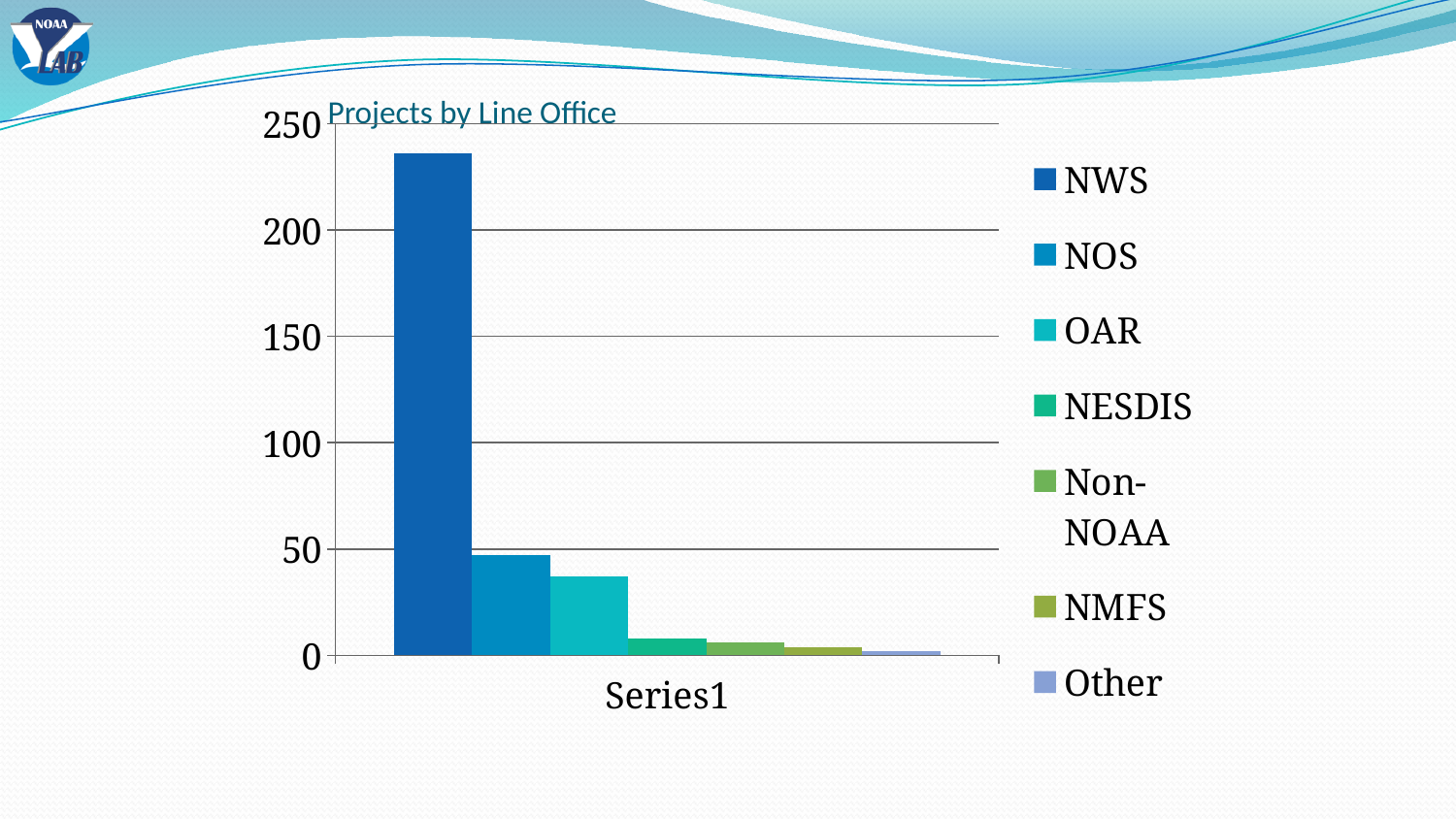
Is the value for NESDIS greater or less than 50? less Which line office has the lowest number of projects? Other Which has more projects, NOS or OAR? NOS How many series does the legend list? 7 What label appears on the x axis below the bars? Series1 What kind of chart is shown on the slide? bar chart How many bars are plotted in the chart? 7 Is the value for NWS greater or less than 200? greater What is the title of the chart? Projects by Line Office Which line office has the highest number of projects? NWS Which has more projects, NWS or NOS? NWS